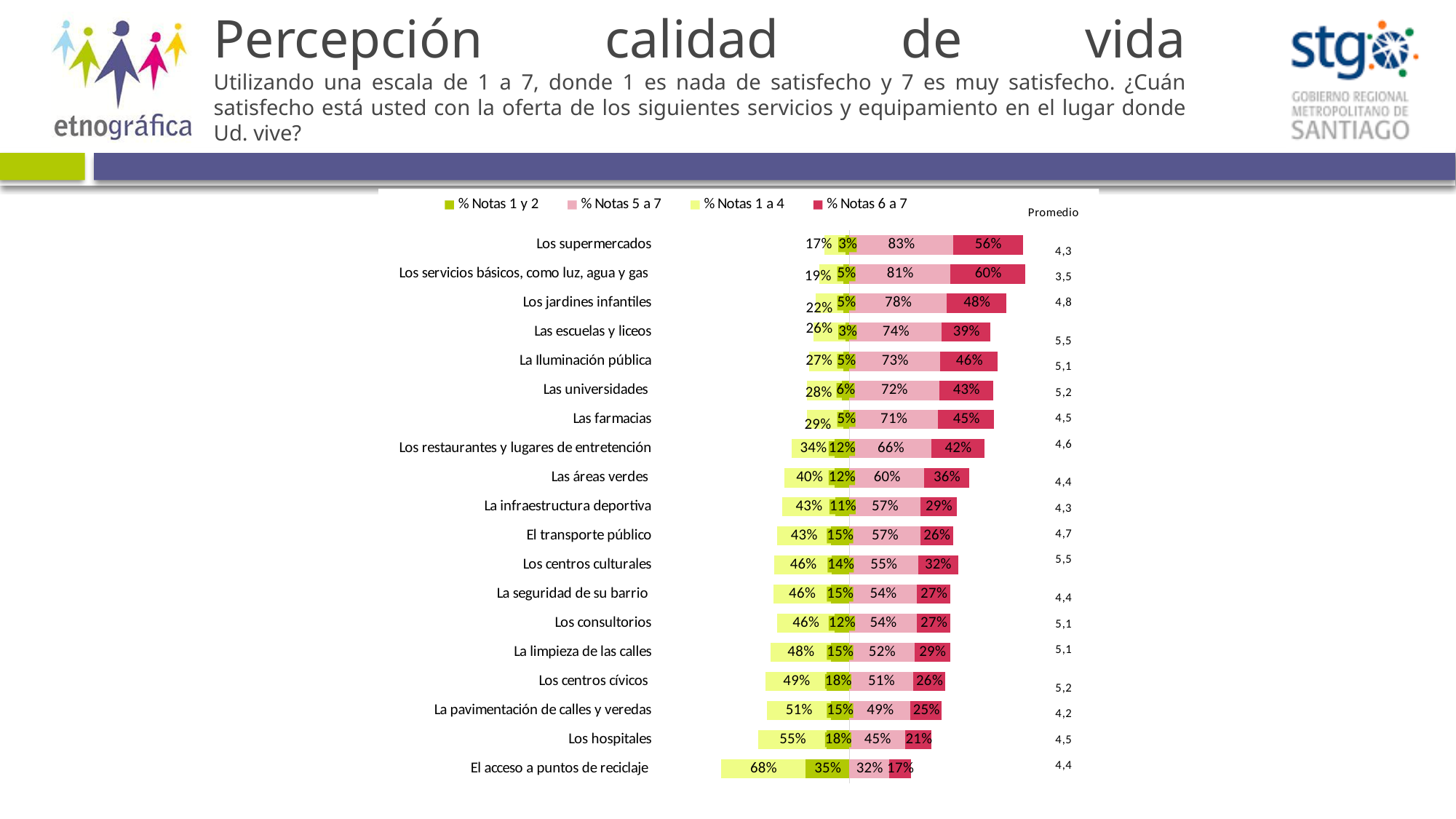
How many categories (services) are shown in the chart? 19 Which category has the highest % Notas 6 a 7 value? Los servicios básicos, como luz, agua y gas How many series does the legend list? 4 What is the difference between the % Notas 5 a 7 and % Notas 6 a 7 values for Los supermercados? 27 percentage points Which has a larger % Notas 6 a 7 value, Las áreas verdes or La infraestructura deportiva? Las áreas verdes What is the % Notas 5 a 7 value for Los supermercados? 83% What is the % Notas 6 a 7 value for Los servicios básicos, como luz, agua y gas? 60% What is the % Notas 1 y 2 value for Los hospitales? 18% What is the Promedio value shown for Los jardines infantiles? 4,8 Which category has the lowest % Notas 5 a 7 value? El acceso a puntos de reciclaje What is the % Notas 1 a 4 value for El acceso a puntos de reciclaje? 68% What kind of chart is shown on the slide? Bar chart